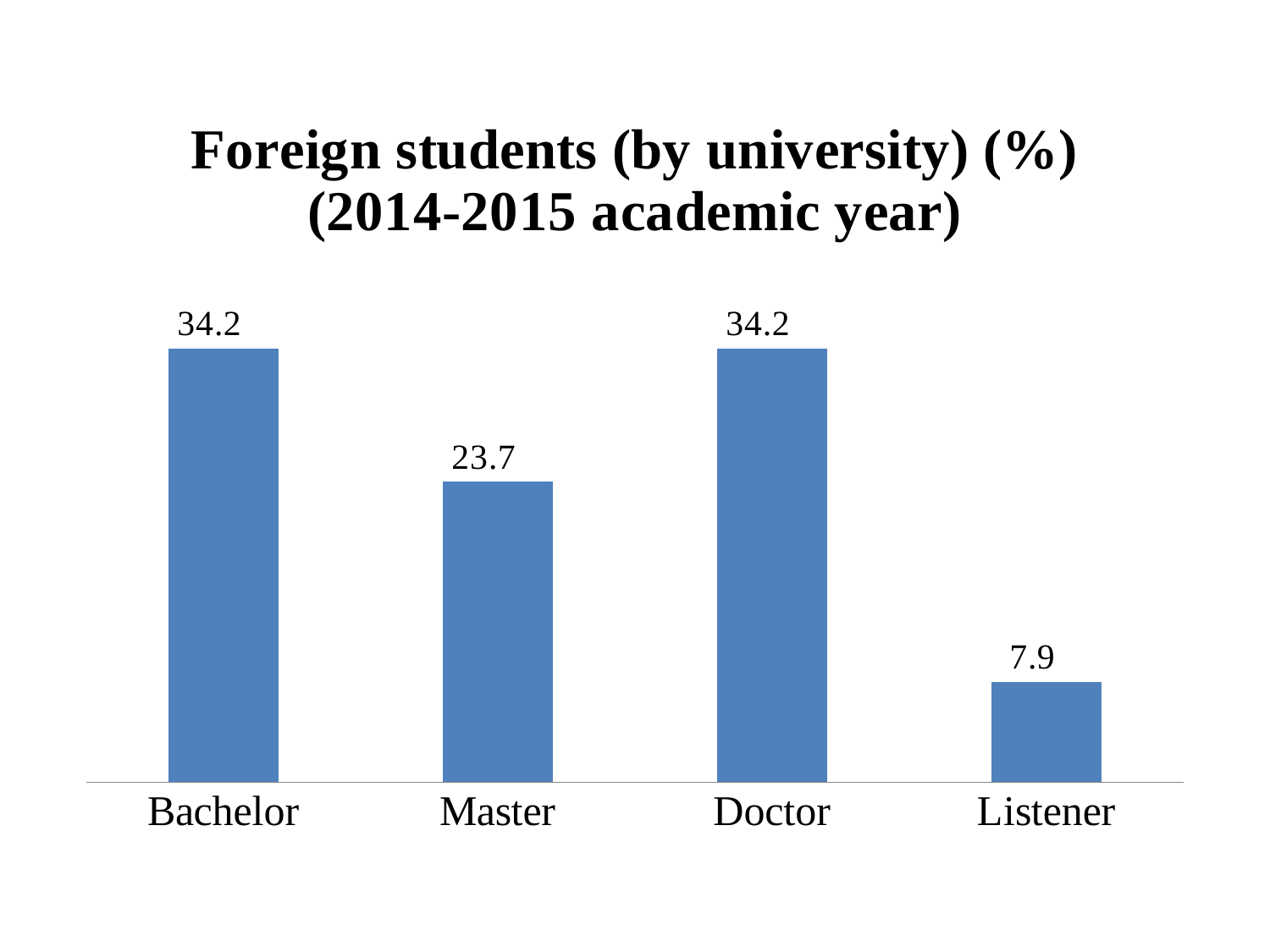
What kind of chart is shown on the slide? Bar chart What is the value for Doctor? 34.2 Which is larger, the value for Doctor or the value for Master? Doctor What is the title of the chart? Foreign students (by university) (%) (2014-2015 academic year) Which category has the lowest value? Listener Which is larger, the value for Master or the value for Listener? Master What is the value for Master? 23.7 What is the difference between the values for Master and Listener? 15.8 What is the difference between the values for Bachelor and Master? 10.5 What is the value for Bachelor? 34.2 How many categories are shown in the chart? 4 What is the value for Listener? 7.9